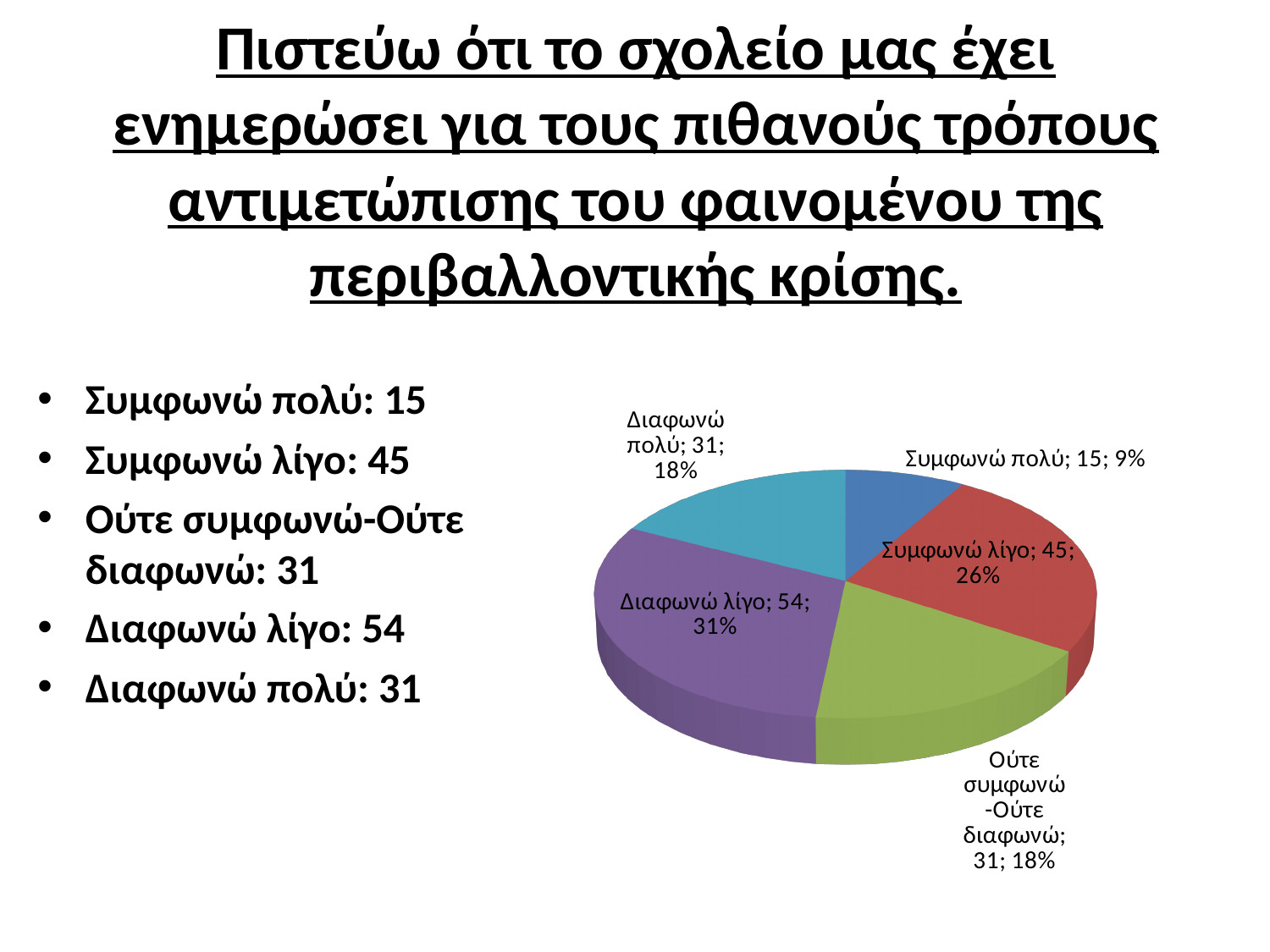
What is the difference between the values for Διαφωνώ λίγο and Συμφωνώ λίγο? 9 What colour is the Διαφωνώ λίγο slice in the pie chart? purple Which is larger, the value for Συμφωνώ λίγο or the value for Ούτε συμφωνώ-Ούτε διαφωνώ? Συμφωνώ λίγο Which category has the largest slice in the pie chart? Διαφωνώ λίγο What is the value for Διαφωνώ λίγο in the pie chart? 54 Which category has the smallest slice in the pie chart? Συμφωνώ πολύ What percentage share does Συμφωνώ λίγο have in the pie chart? 26% What kind of chart is shown on the slide? pie chart What is the value for Συμφωνώ πολύ in the pie chart? 15 What percentage share does Διαφωνώ πολύ have in the pie chart? 18% How many slices does the pie chart have? 5 What is the total of all the values in the pie chart? 176